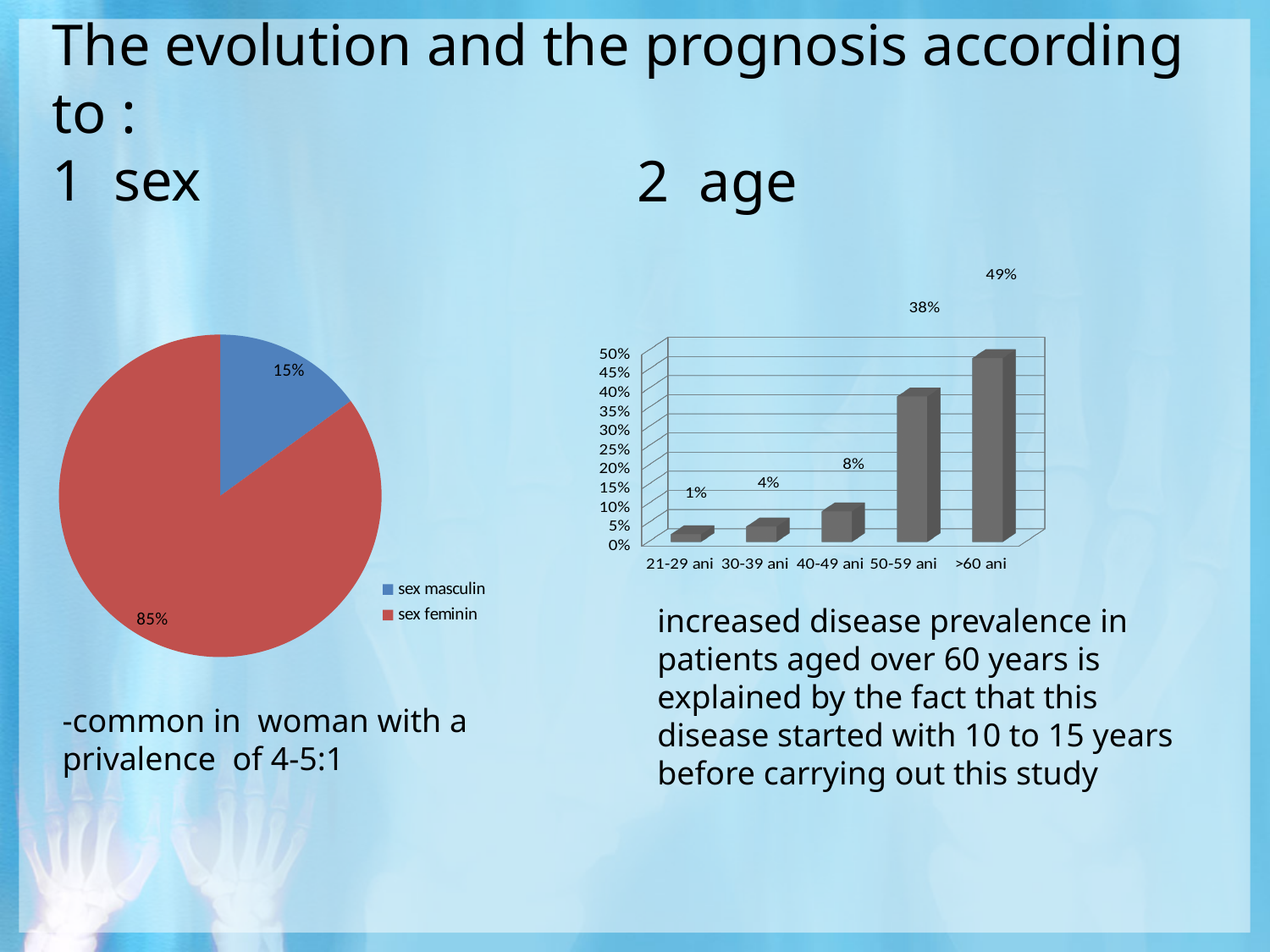
In the pie chart on the left, what colour is the sex masculin slice? Blue In the bar chart on the right, what is the value for the 40-49 ani group? 8% In the bar chart on the right, what is the difference between the values for >60 ani and 50-59 ani? 11% In the bar chart on the right, what is the value for the >60 ani group? 49% In the pie chart on the left, what share is labelled for sex feminin? 85% In the pie chart on the left, what share is labelled for sex masculin? 15% In the pie chart on the left, how many entries does the legend list? 2 In the bar chart on the right, which age group has the lowest value? 21-29 ani In the bar chart on the right, which age group has the highest value? >60 ani In the bar chart on the right, do the values rise or fall from 21-29 ani to >60 ani? Rise In the pie chart on the left, which category has the larger slice? sex feminin In the bar chart on the right, how many age groups are shown? 5